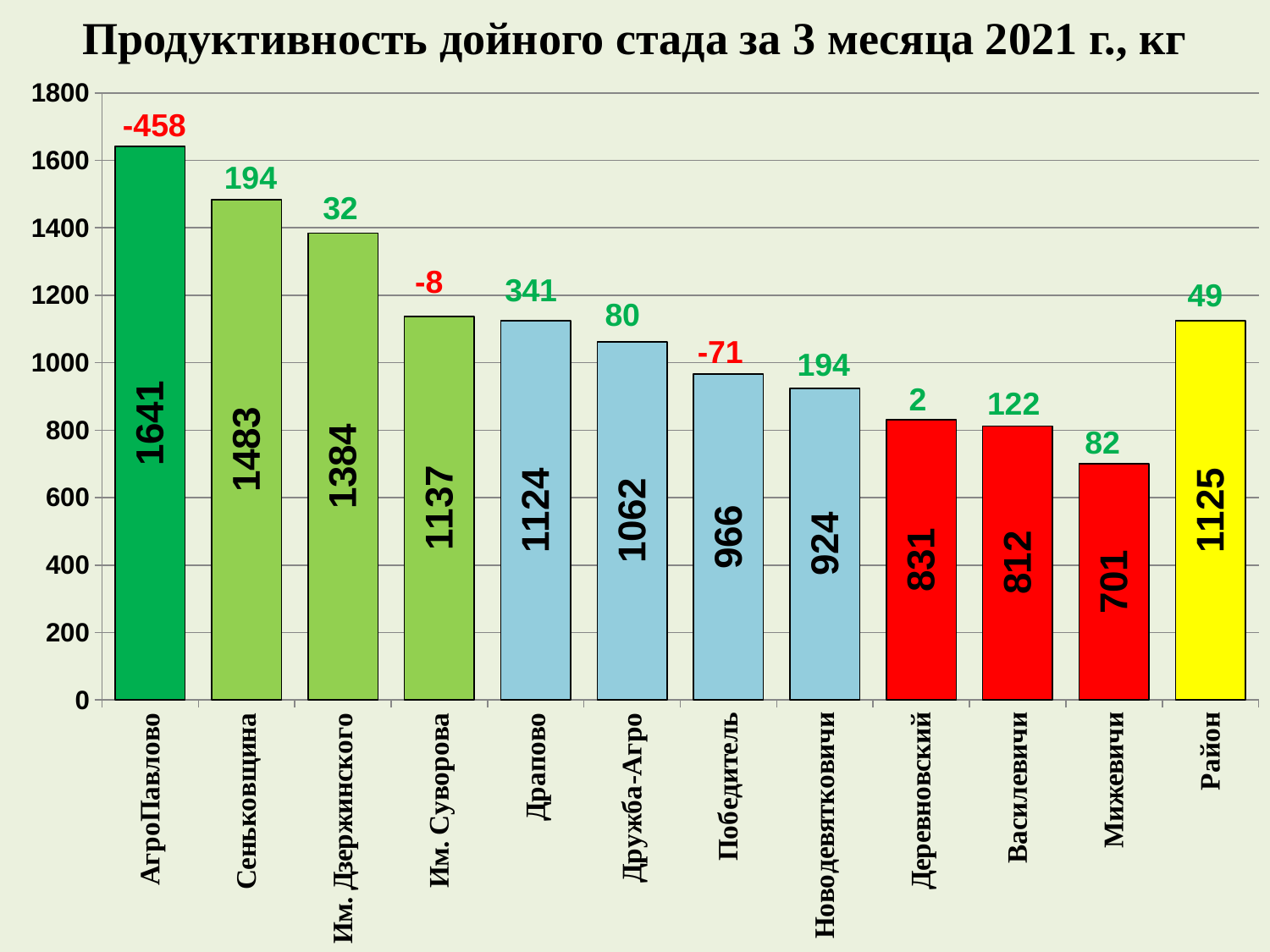
Which is larger, the value for Драпово or the value for Дружба-Агро? Драпово How many categories are shown on the x axis? 12 What is the value for АгроПавлово? 1641 Is the value for Василевичи greater or less than 1000? less What is the value for Победитель? 966 What kind of chart is this? bar chart What colour is the bar for Район? yellow What is the difference between the values for Сеньковщина and Им. Дзержинского? 99 What is the chart title? Продуктивность дойного стада за 3 месяца 2021 г., кг What is the value for Район? 1125 Which category has the lowest value? Мижевичи Which category has the highest value? АгроПавлово